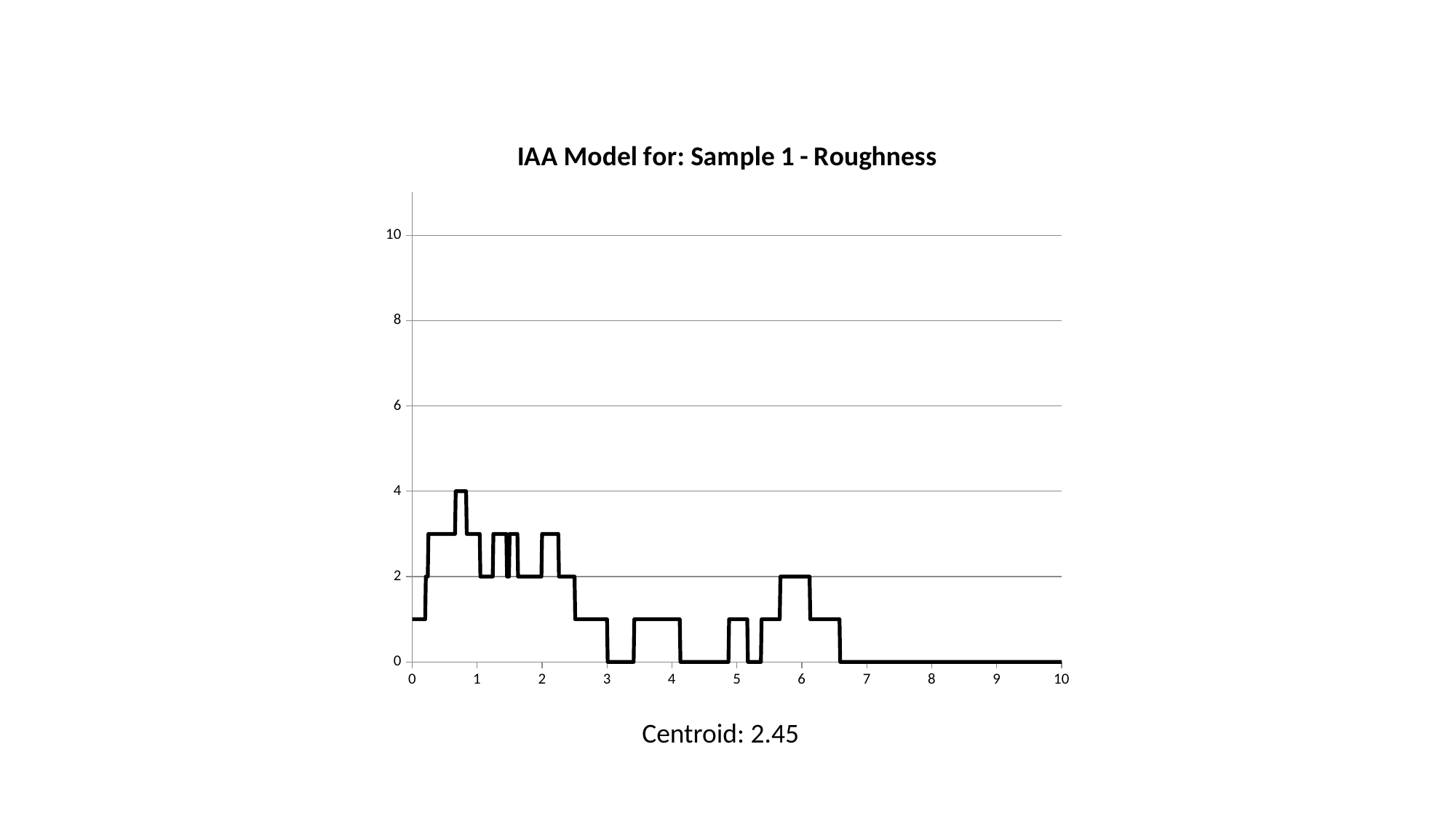
What is the maximum value shown on the y axis? 10 What centroid value is stated below the chart? 2.45 Is the value of the line at x = 4 greater or less than 2? less What is the value of the line at x = 9? 0 What is the title of the chart? IAA Model for: Sample 1 - Roughness What kind of chart is shown on the slide? line chart Overall, do the values rise or fall as x increases from 0 to 10? fall Is the value of the line at x = 7 greater or less than 1? less What is the value of the line at x = 8? 0 Is the peak value of the line, near x = 0.75, greater or less than 2? greater What is the lowest value the line reaches? 0 What is the highest value the line reaches? 4